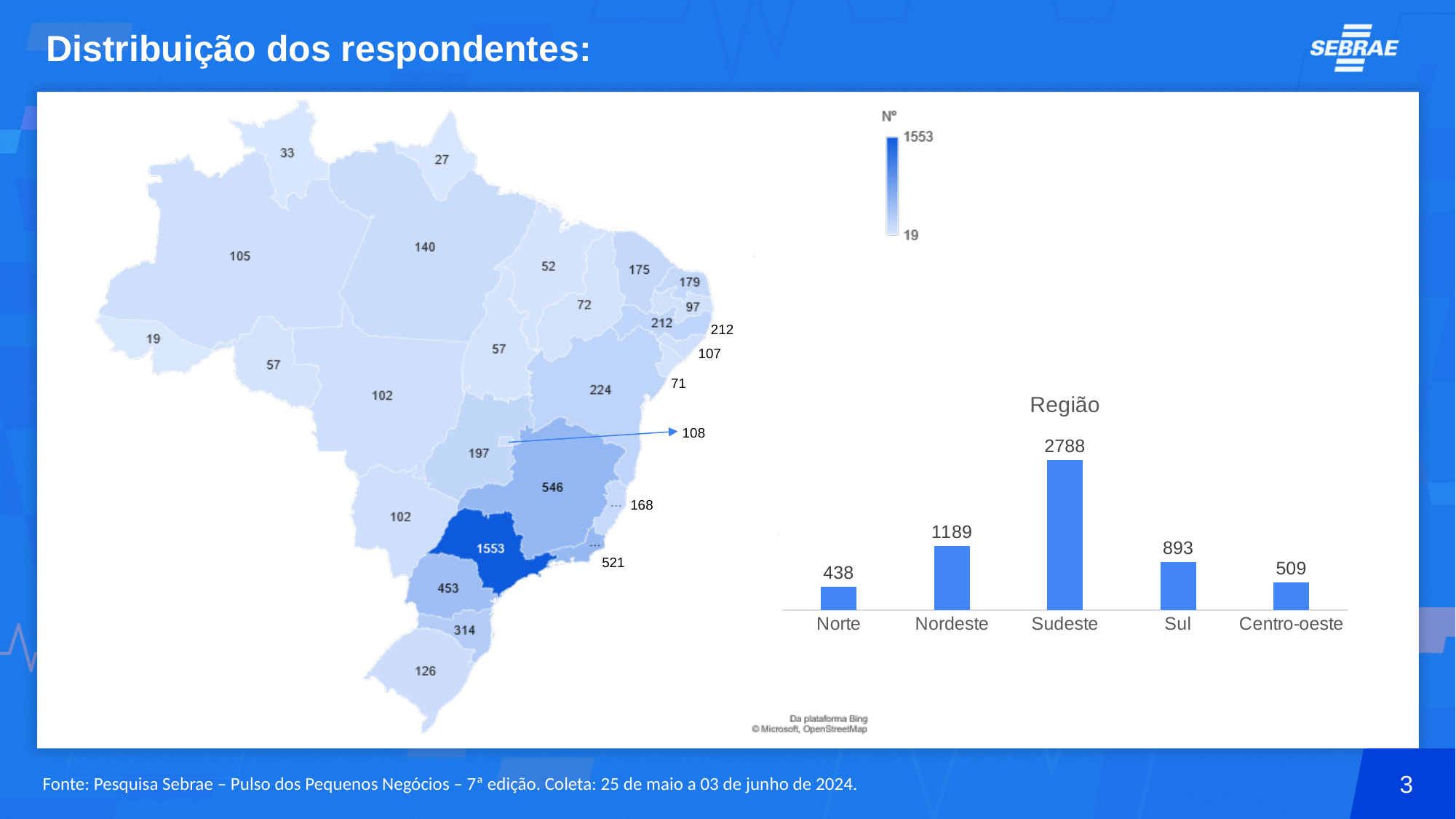
On the map chart on the left, what is the highest value shown in the colour legend? 1553 In the 'Região' bar chart, which is larger, the value for Nordeste or the value for Sul? Nordeste On the map chart on the left, what is the lowest value shown in the colour legend? 19 What kind of chart is the 'Região' chart on the right of the slide? Bar chart In the 'Região' bar chart, which region has the highest value? Sudeste In the 'Região' bar chart, which region has the lowest value? Norte In the 'Região' bar chart, what is the difference between the values for Sul and Centro-oeste? 384 In the 'Região' bar chart, what is the difference between the values for Sudeste and Nordeste? 1599 How many regions are shown in the 'Região' bar chart? 5 In the 'Região' bar chart, what is the value for Sudeste? 2788 In the 'Região' bar chart, what is the value for Norte? 438 In the 'Região' bar chart, what is the value for Centro-oeste? 509